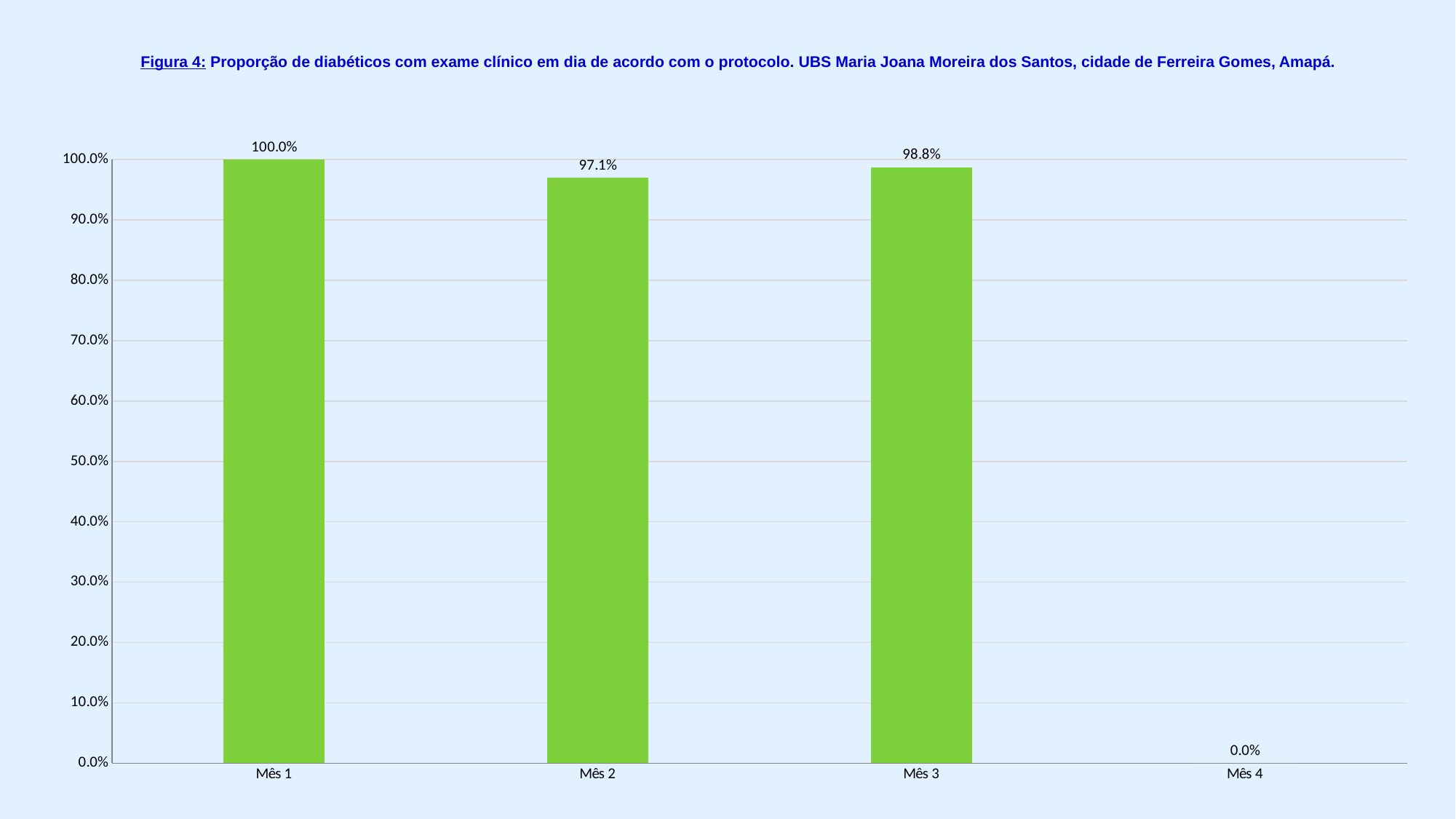
How many months are shown on the x axis? 4 What is the value for Mês 3? 98.8% What is the difference between the values for Mês 3 and Mês 2? 1.7% What kind of chart is shown on the slide? Bar chart What is the difference between the values for Mês 1 and Mês 2? 2.9% What is the value for Mês 2? 97.1% Which month has the lowest value? Mês 4 Which month has the highest value? Mês 1 What is the value for Mês 4? 0.0% What is the value for Mês 1? 100.0% What colour are the bars in the chart? Green Which is larger, the value for Mês 2 or the value for Mês 3? Mês 3